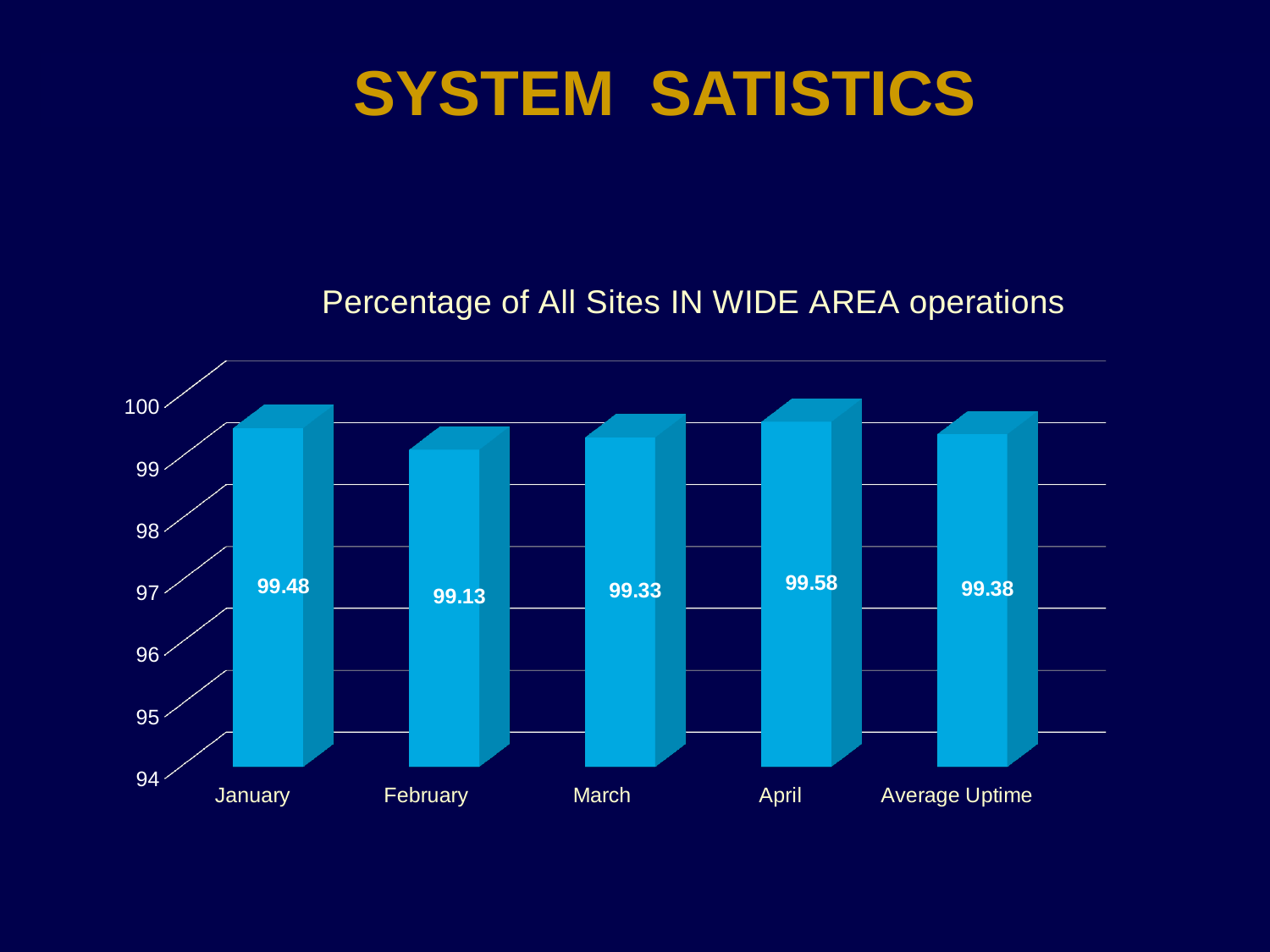
What is the title of the chart? Percentage of All Sites IN WIDE AREA operations What is the value for January? 99.48 What kind of chart is shown on the slide? bar chart Which is larger, the value for March or the value for January? January Which category has the highest value? April How many categories are shown on the x axis? 5 What is the difference between the values for April and February? 0.45 Is the value for April greater or less than 99? greater What is the value for Average Uptime? 99.38 What is the value for February? 99.13 Which category has the lowest value? February What is the lowest value shown on the vertical axis? 94